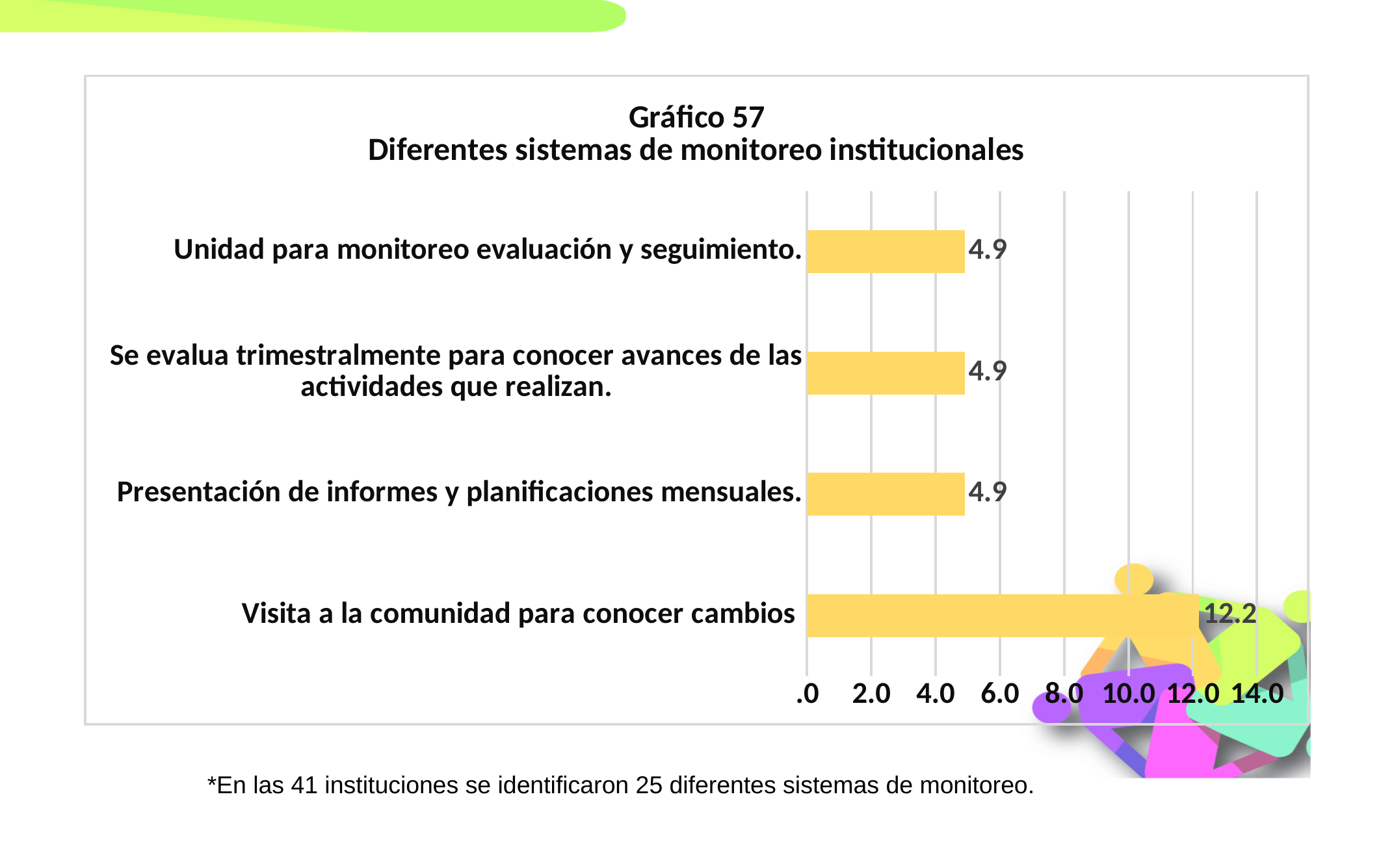
Is the value for "Visita a la comunidad para conocer cambios" greater or less than 10.0? greater What is the value for "Visita a la comunidad para conocer cambios"? 12.2 What is the highest value shown on the x axis? 14.0 What kind of chart is shown on the slide? bar chart What is the difference between the value for "Visita a la comunidad para conocer cambios" and the value for "Presentación de informes y planificaciones mensuales."? 7.3 What is the value for "Presentación de informes y planificaciones mensuales."? 4.9 Which is larger: the value for "Visita a la comunidad para conocer cambios" or the value for "Se evalua trimestralmente para conocer avances de las actividades que realizan."? Visita a la comunidad para conocer cambios Is the value for "Unidad para monitoreo evaluación y seguimiento." greater or less than 6.0? less What is the title of the chart? Gráfico 57 Diferentes sistemas de monitoreo institucionales How many categories are shown in the chart? 4 What is the value for "Unidad para monitoreo evaluación y seguimiento."? 4.9 Which category has the highest value? Visita a la comunidad para conocer cambios